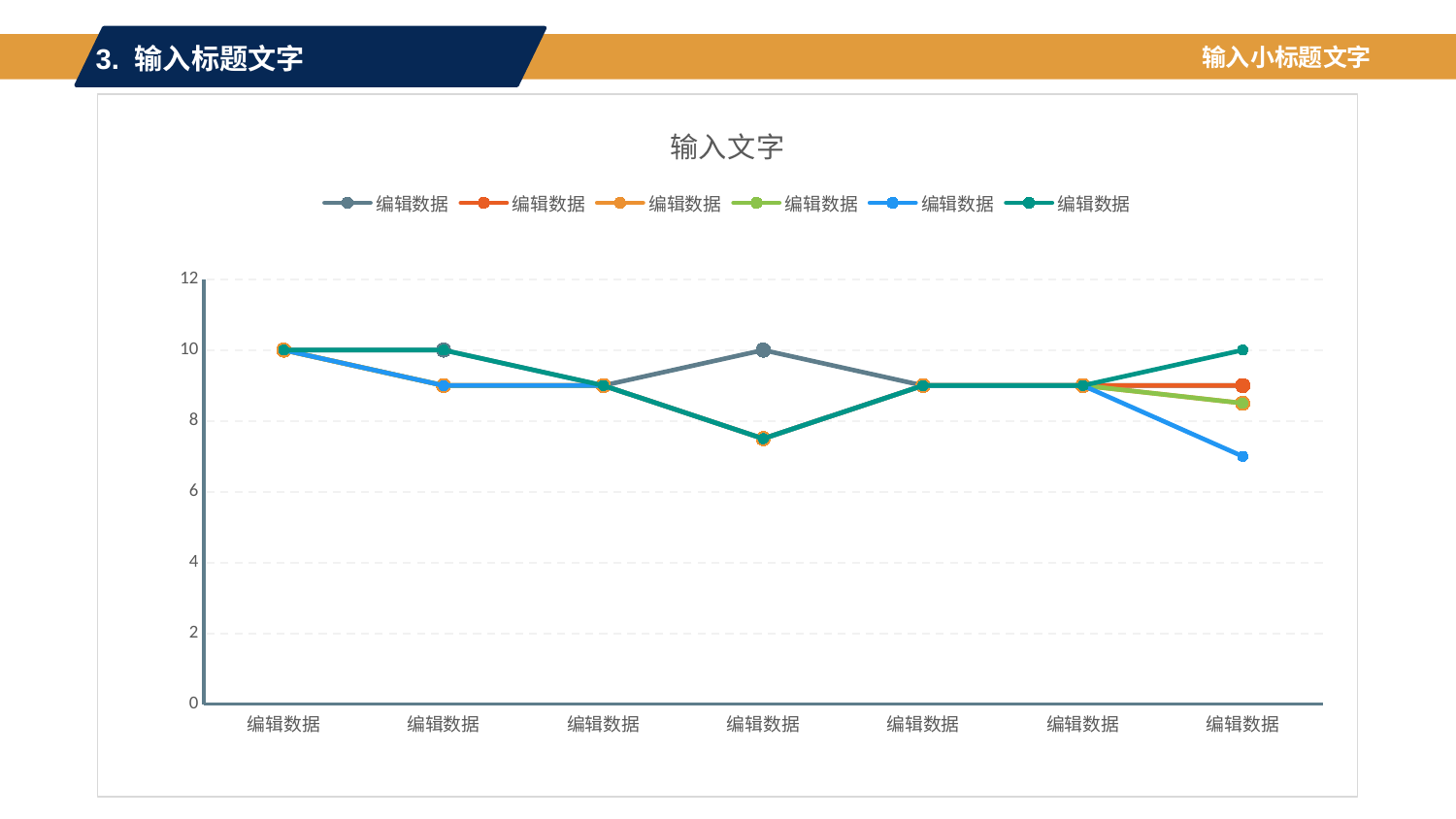
At the last (rightmost) category, which series has the higher value, the teal series or the blue series? the teal series How many series does the legend list? 6 Is the value of the teal series at the fourth category from the left greater or less than 8? less How many categories are shown along the x axis? 7 Does the blue series rise or fall from the sixth category to the seventh category? fall What is the highest value shown on the y axis? 12 Is the value of the dark grey series at the fourth category from the left greater or less than 8? greater Is the value of the blue series at the last (rightmost) category greater or less than 8? less What kind of chart is shown on the slide? line chart What is the title of the chart? 输入文字